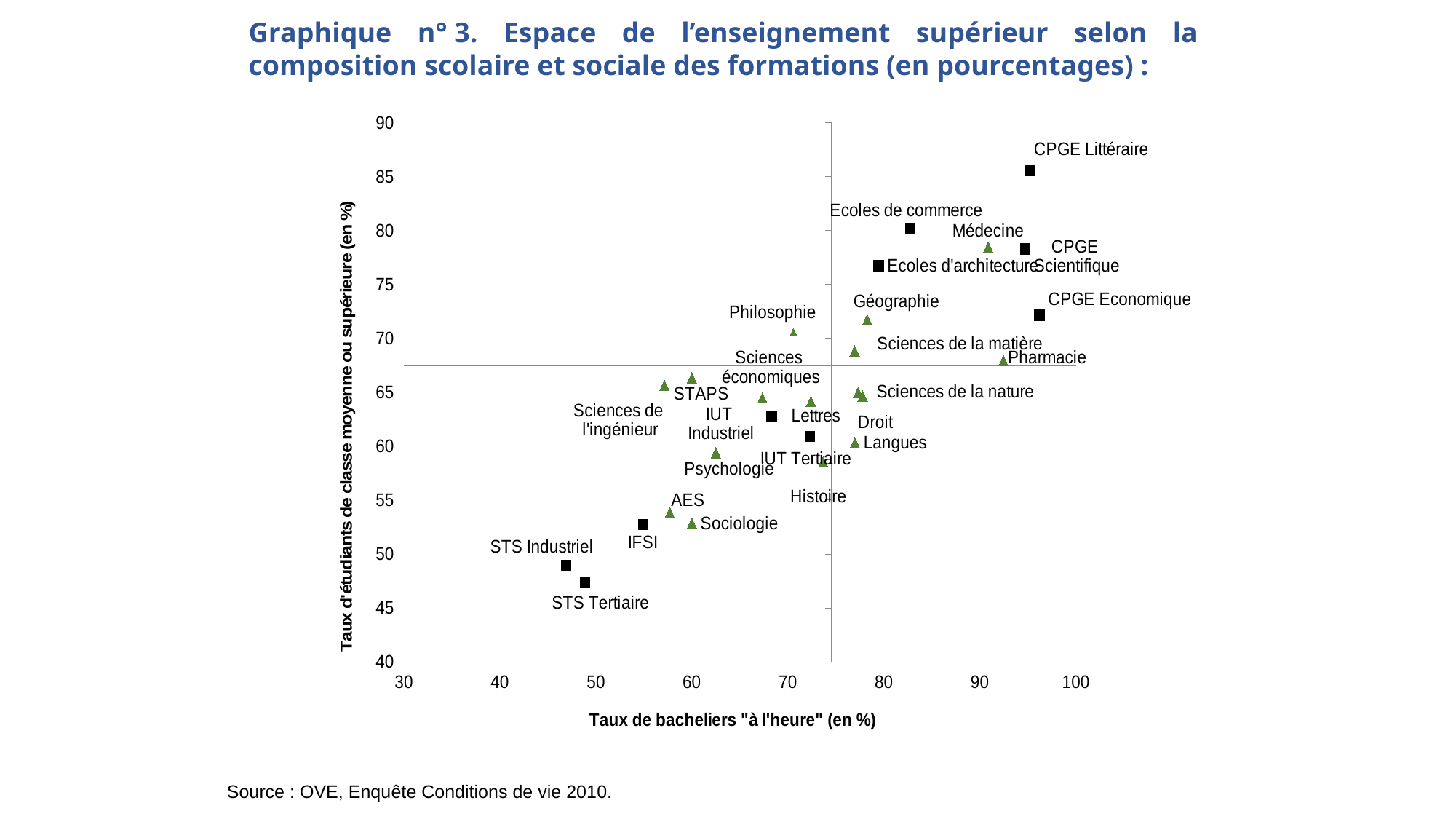
Which has a higher y-axis value, CPGE Littéraire or STS Tertiaire? CPGE Littéraire Which formation has the highest rate of students from middle or upper class (y axis)? CPGE Littéraire Is the y-axis value for Ecoles de commerce greater or less than 70? greater Which formation has the lowest rate of bacheliers "à l'heure" (x axis)? STS Industriel Which has a higher rate of bacheliers "à l'heure" (x axis), Pharmacie or Philosophie? Pharmacie What kind of chart is shown on the slide? scatter chart Is the y-axis value for Sociologie greater or less than 55? less Is the x-axis value for Pharmacie greater or less than 90? greater What is the title of the x axis? Taux de bacheliers "à l'heure" (en %) Do the y-axis values generally rise or fall as the x-axis value increases? rise Which formation has the lowest rate of students from middle or upper class (y axis)? STS Tertiaire